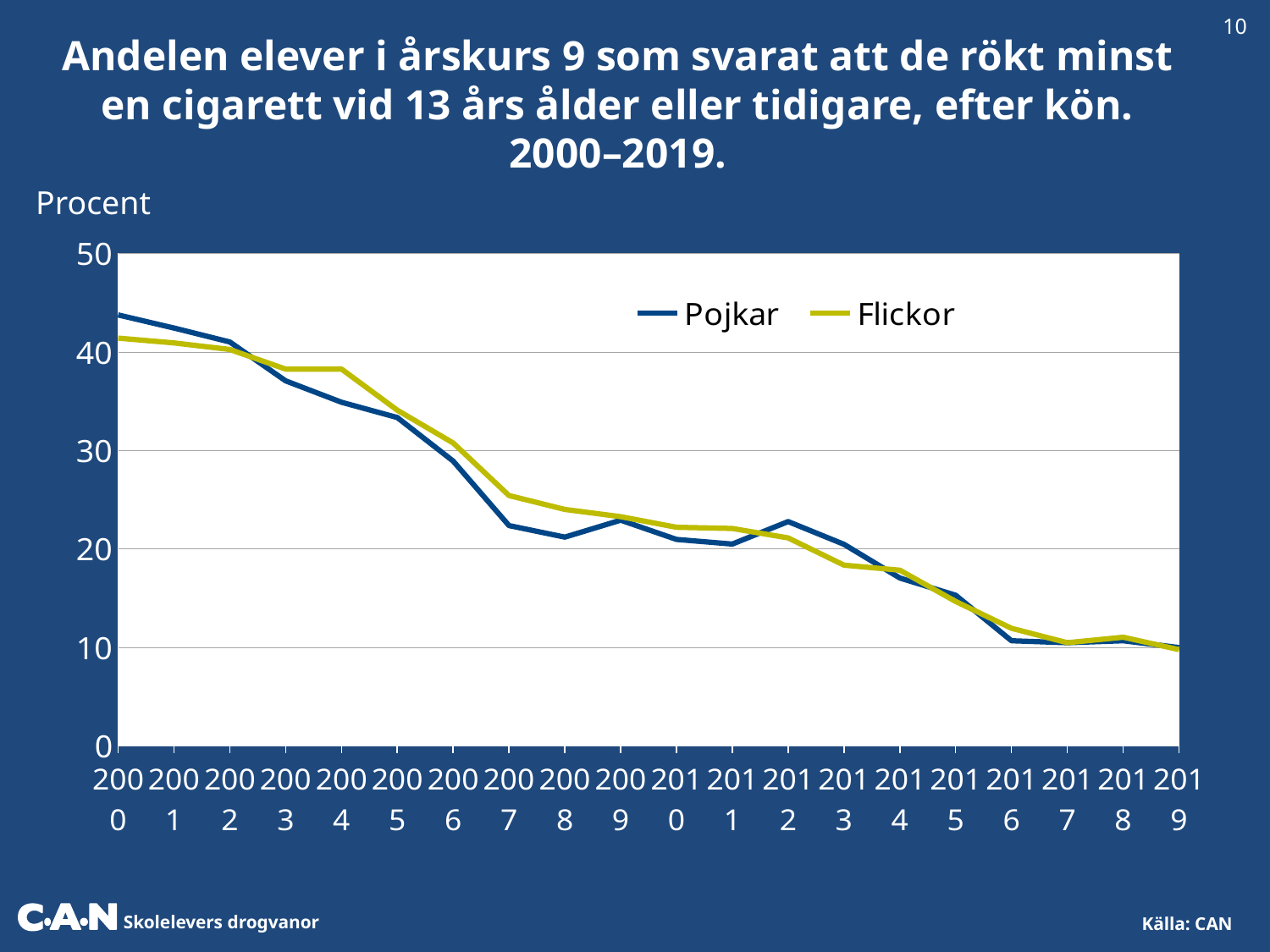
How many years are plotted along the x axis? 20 Is the value for Flickor in 2007 greater or less than 30? less In 2012, which series has the higher value, Pojkar or Flickor? Pojkar Is the value for Pojkar in 2000 greater or less than 40? greater Is the value for Flickor in 2013 greater or less than 20? less In 2004, which series has the higher value, Pojkar or Flickor? Flickor In which year is the value for Pojkar highest? 2000 How many series does the legend list? 2 Which two series are listed in the legend? Pojkar and Flickor Do the values for Pojkar generally rise or fall from 2000 to 2019? fall What kind of chart is shown on the slide? line chart